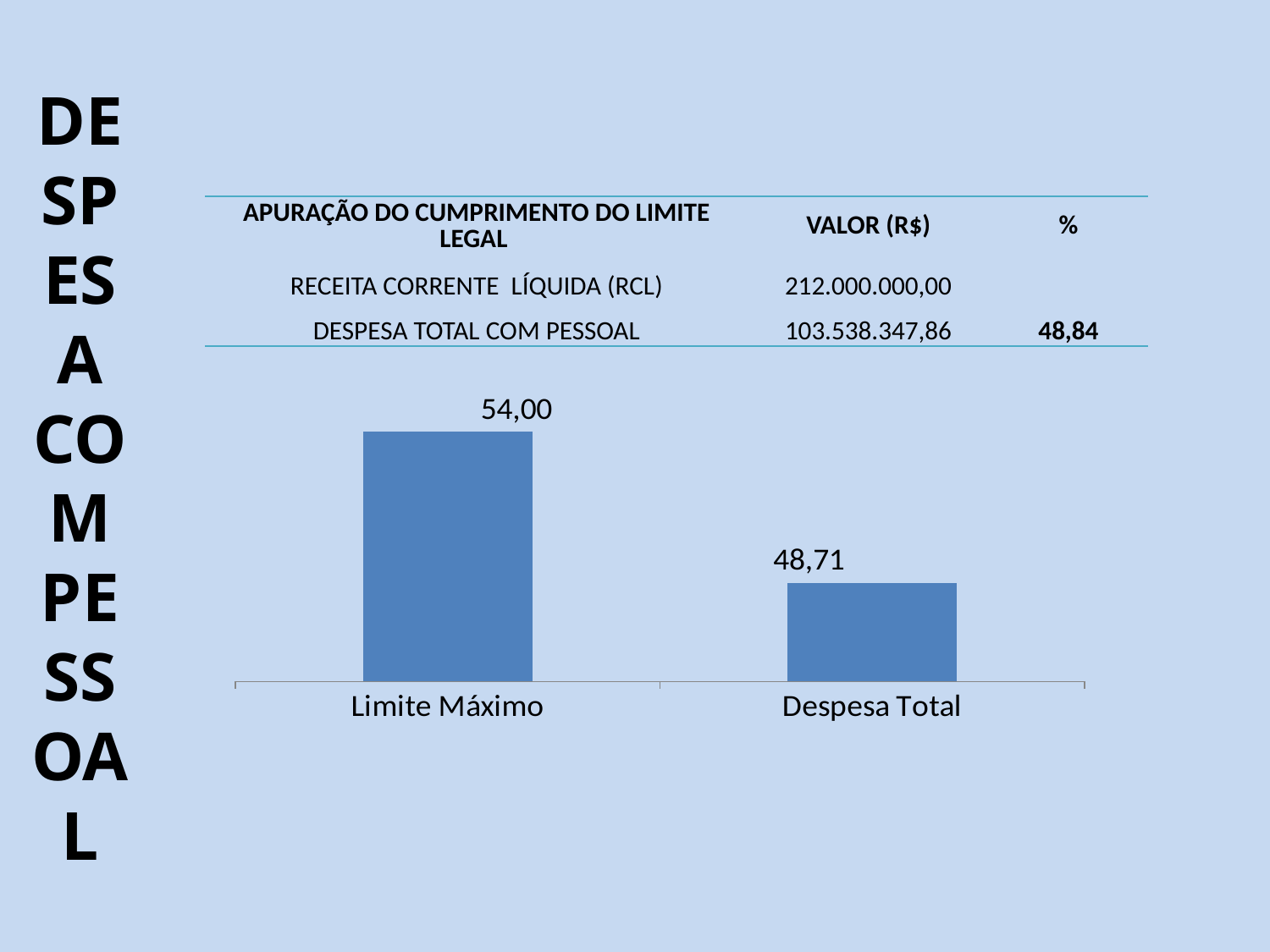
Do the values in the bar chart rise or fall from left to right? Fall What kind of chart is shown on the slide? Bar chart What is the label of the first category on the x axis of the bar chart? Limite Máximo What colour are the bars in the bar chart? Blue What is the difference between the values for Limite Máximo and Despesa Total in the bar chart? 5,29 Which category has the lowest value in the bar chart? Despesa Total How many categories are shown in the bar chart? 2 What is the value for Limite Máximo in the bar chart? 54,00 What is the value for Despesa Total in the bar chart? 48,71 Which is larger in the bar chart, Limite Máximo or Despesa Total? Limite Máximo Which category has the highest value in the bar chart? Limite Máximo